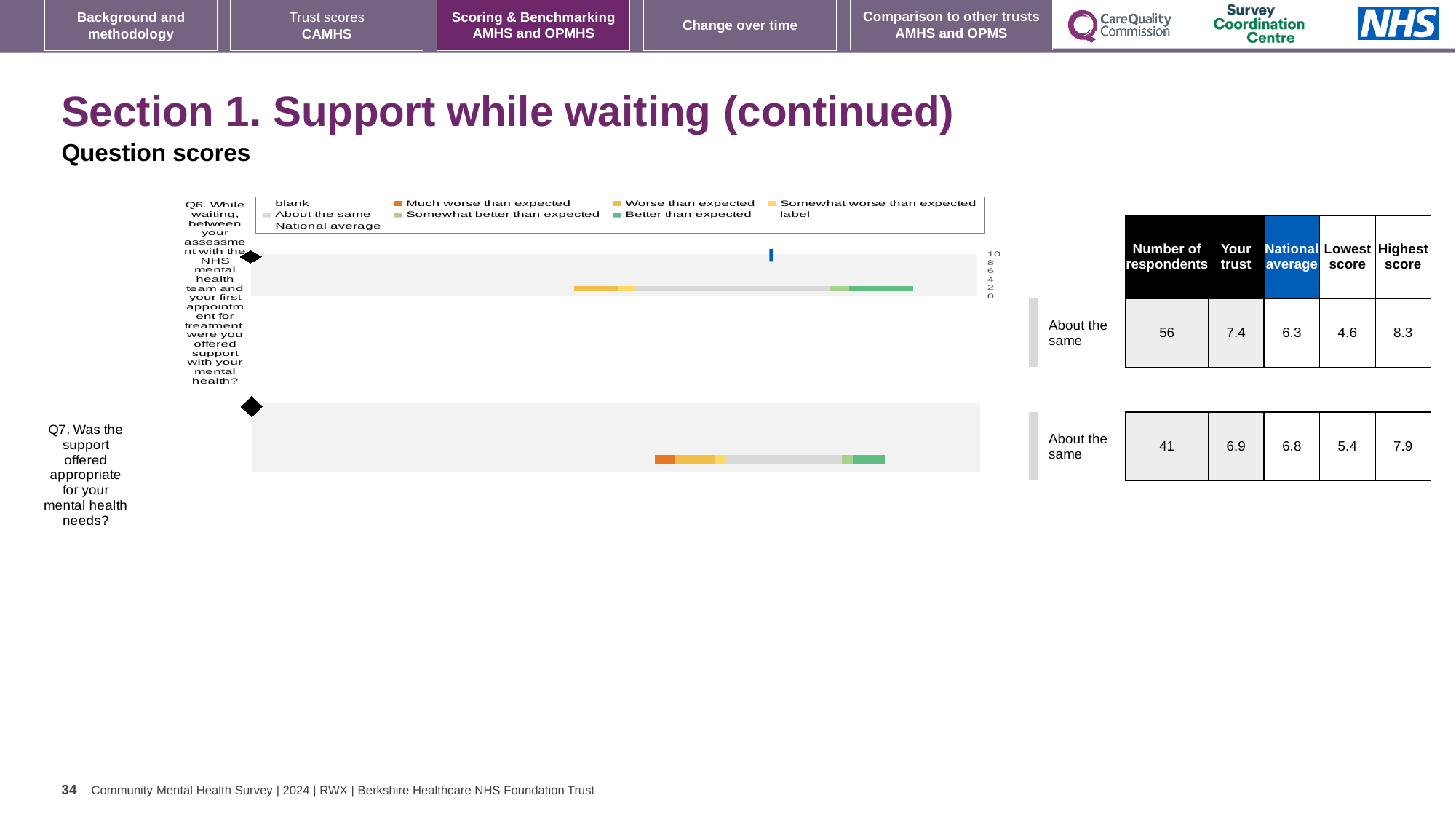
How many respondents answered Q7? 41 Which question has the higher 'Your trust' score, Q6 or Q7? Q6 What is the 'Your trust' score for Q6 (support with your mental health while waiting)? 7.4 What kind of chart is used to show the question scores on this slide? bar chart How many respondents answered Q6? 56 What rating label is given to the trust's score for Q7 relative to other trusts? About the same How many questions (categories) are plotted in the chart? 2 What is the national average score for Q7 (was the support offered appropriate for your mental health needs)? 6.8 What is the lowest score shown for Q7? 5.4 What is the difference between the 'Your trust' score and the national average for Q6? 1.1 Which column header in the table is highlighted in blue? National average What is the highest score shown for Q6? 8.3